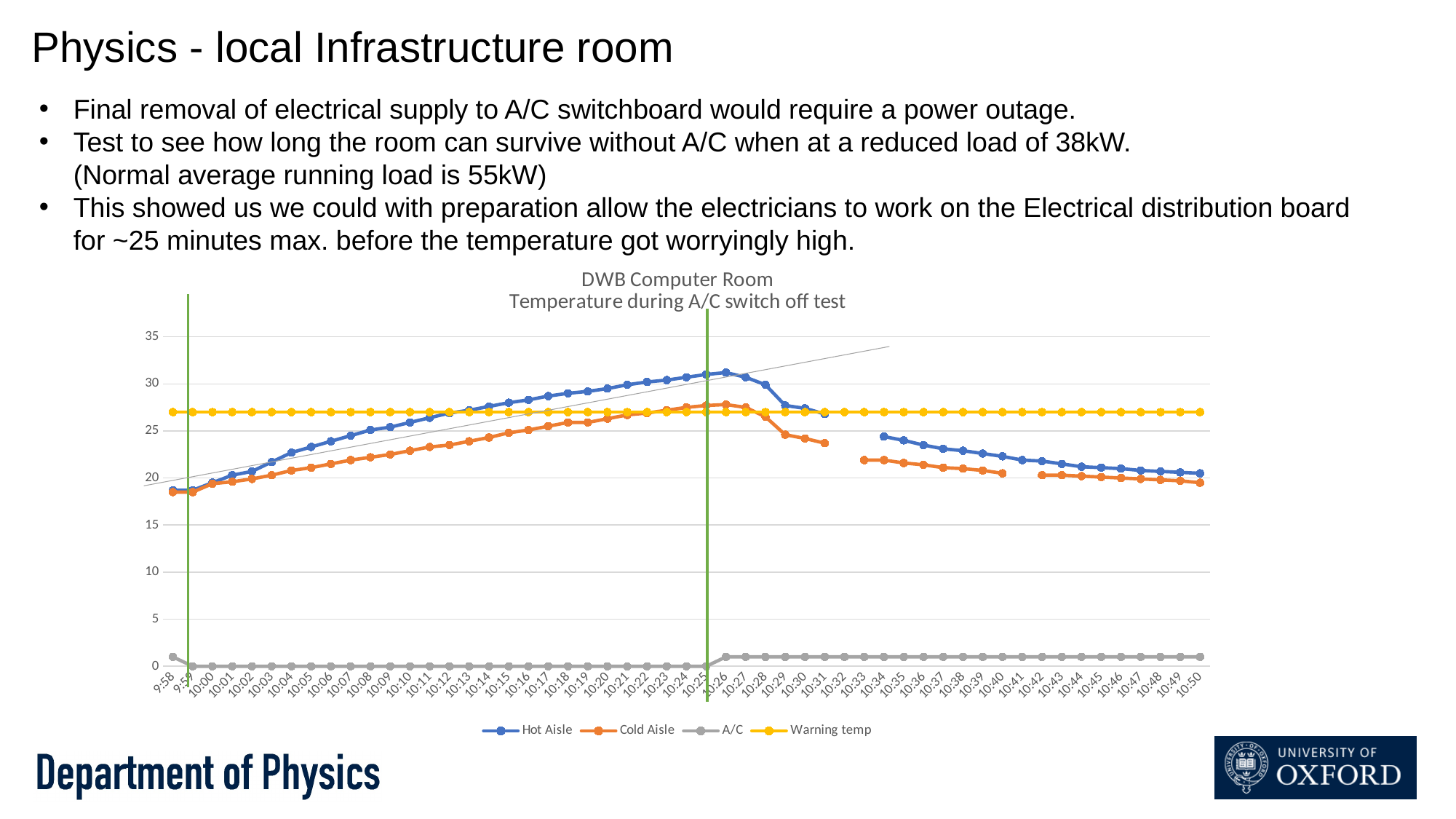
What is the title of the chart? DWB Computer Room Temperature during A/C switch off test What are the series names listed in the chart legend? Hot Aisle, Cold Aisle, A/C, Warning temp Which series has the highest value at 10:26? Hot Aisle Is the Cold Aisle value at 10:26 greater or less than 25? greater Is the Hot Aisle value at 10:26 greater or less than 30? greater At 10:20, which is higher, the Hot Aisle or the Cold Aisle? Hot Aisle Is the Hot Aisle value at 9:58 greater or less than 20? less How many series does the chart legend list? 4 What kind of chart is shown on the slide? line chart Does the Hot Aisle temperature rise or fall between 9:58 and 10:26? rise